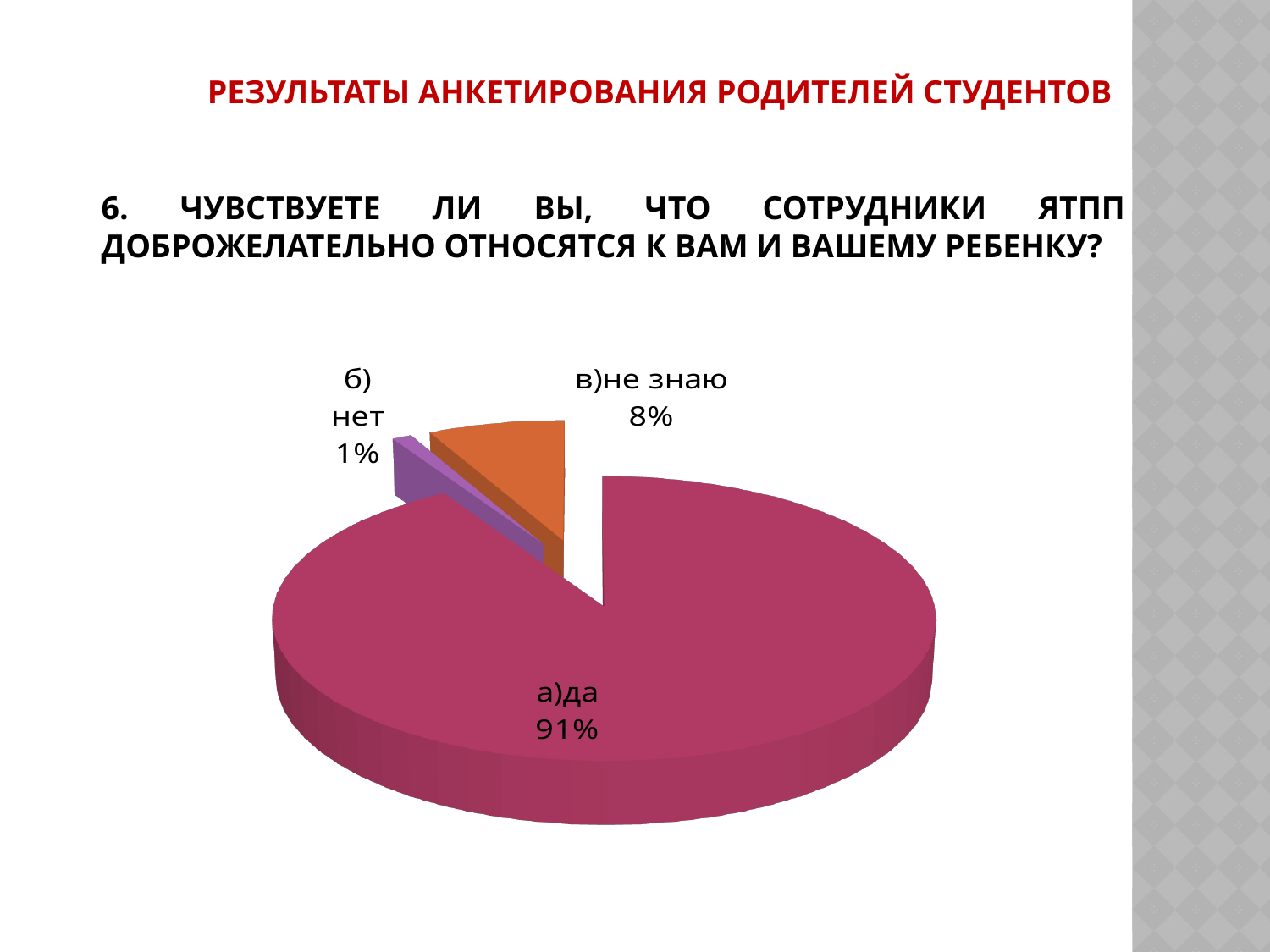
What share of the pie does the slice "а)да" represent? 91% What colour is the "а)да" slice of the pie? magenta (dark pink) How many slices does the pie chart have? 3 Which slice of the pie is the smallest? б) нет What colour is the "в)не знаю" slice of the pie? orange What share of the pie does the slice "б) нет" represent? 1% What share of the pie does the slice "в)не знаю" represent? 8% What is the difference in percentage points between the "а)да" slice and the "в)не знаю" slice? 83 What is the difference in percentage points between the "в)не знаю" slice and the "б) нет" slice? 7 Which slice of the pie is the largest? а)да Which is larger, the "в)не знаю" slice or the "б) нет" slice? в)не знаю What kind of chart is shown on the slide? pie chart